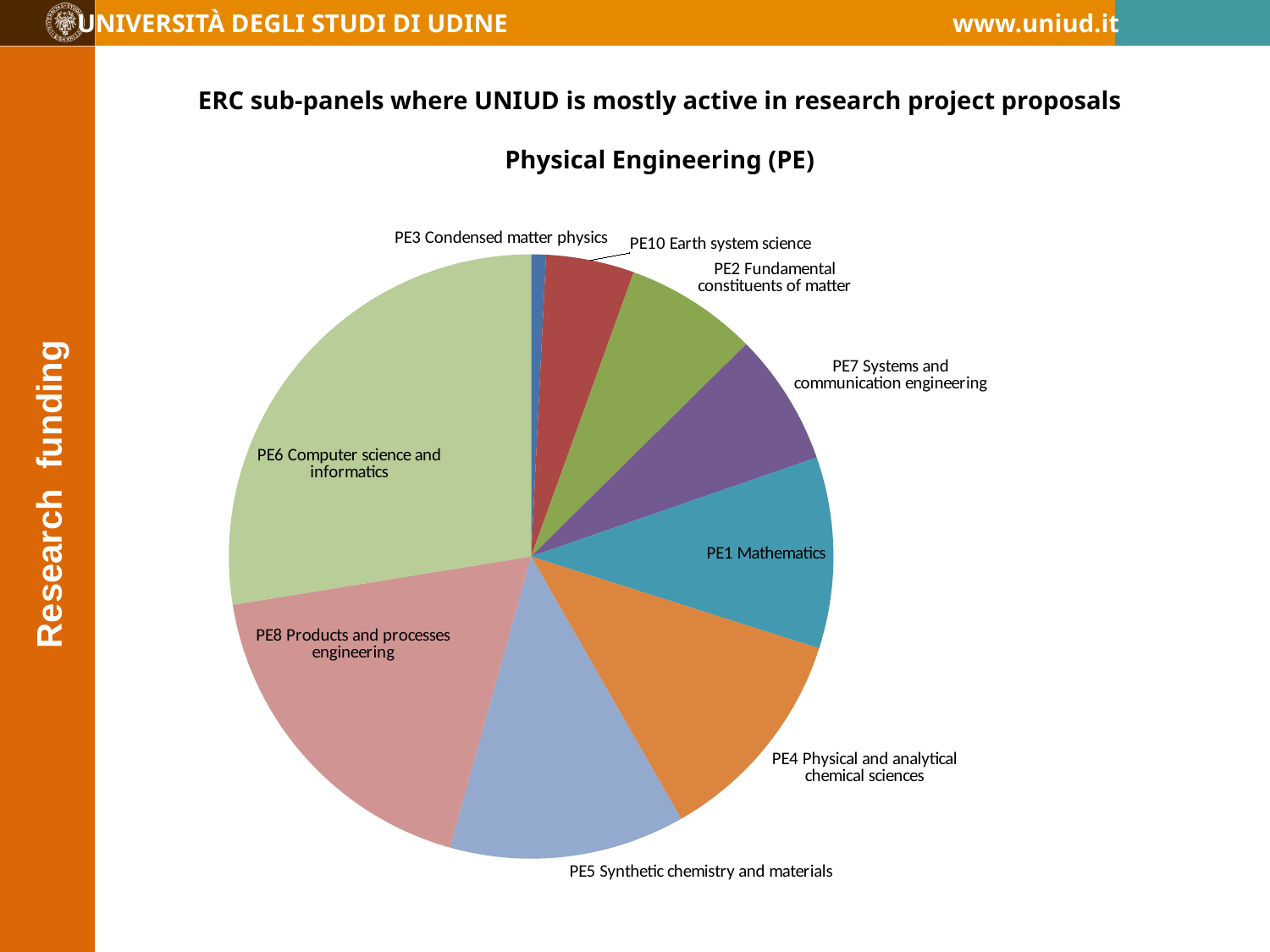
Which slice is larger: PE4 Physical and analytical chemical sciences or PE7 Systems and communication engineering? PE4 Physical and analytical chemical sciences What colour is the slice for PE6 Computer science and informatics? Light green How many ERC sub-panels (slices) are shown in the pie chart? 9 Which ERC sub-panel has the smallest slice of the pie? PE3 Condensed matter physics Which ERC sub-panel has the largest slice of the pie? PE6 Computer science and informatics Which slice is larger: PE5 Synthetic chemistry and materials or PE2 Fundamental constituents of matter? PE5 Synthetic chemistry and materials Which ERC panel does the pie chart cover, according to the chart title? Physical Engineering (PE) Which slice is larger: PE6 Computer science and informatics or PE8 Products and processes engineering? PE6 Computer science and informatics What kind of chart is shown on the slide? Pie chart